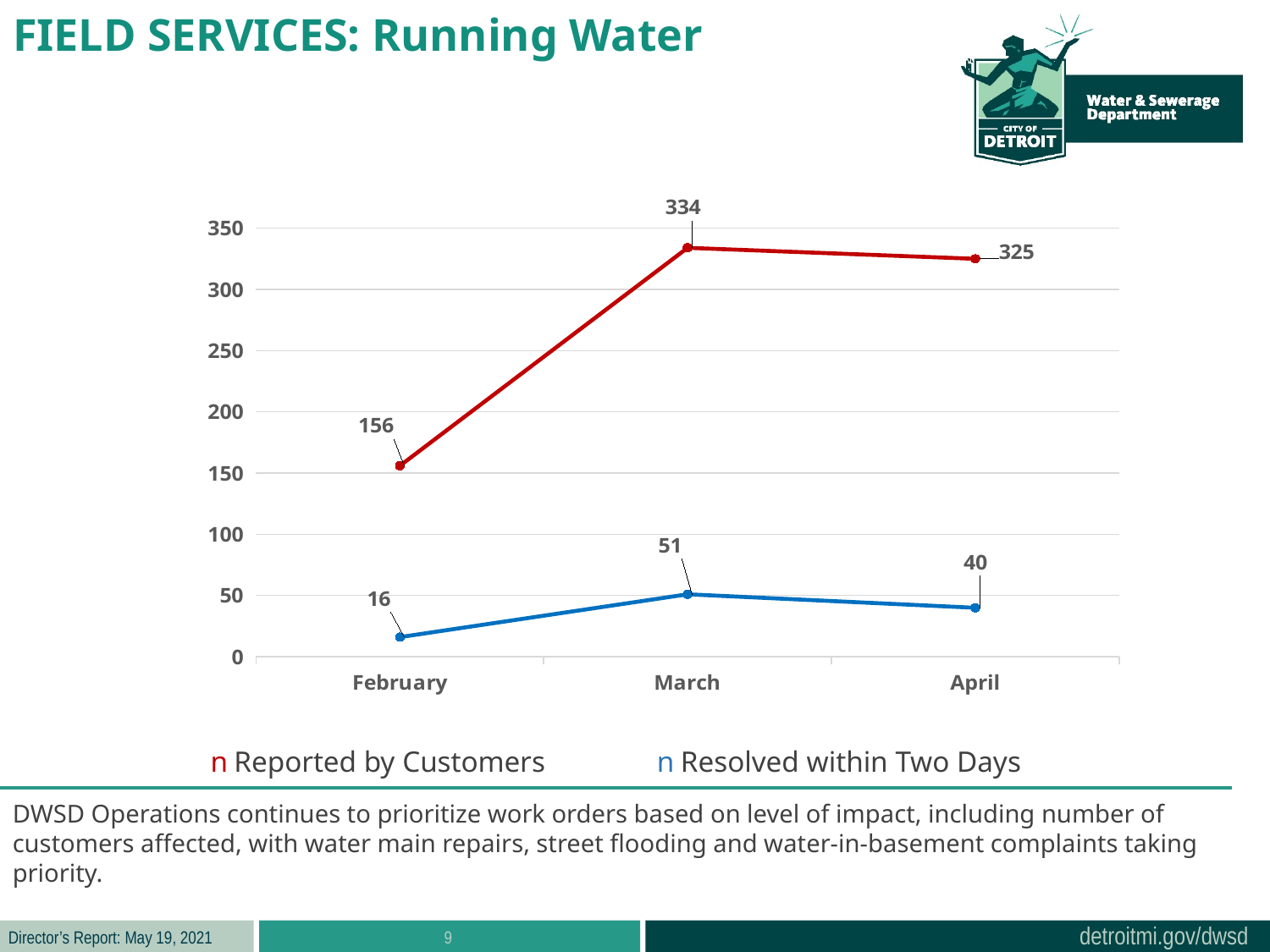
Which is larger: Resolved within Two Days in March or in April? March Does Reported by Customers rise or fall from February to March? Rise How many months are plotted on the x axis? 3 How many series does the legend list? 2 In which month is Reported by Customers highest? March What colour is the line for Reported by Customers? Red What is the value for Reported by Customers in March? 334 What is the difference between Reported by Customers in March and in February? 178 What is the value for Resolved within Two Days in February? 16 What is the value for Reported by Customers in April? 325 What type of chart is shown on the slide? Line chart In which month is Resolved within Two Days lowest? February